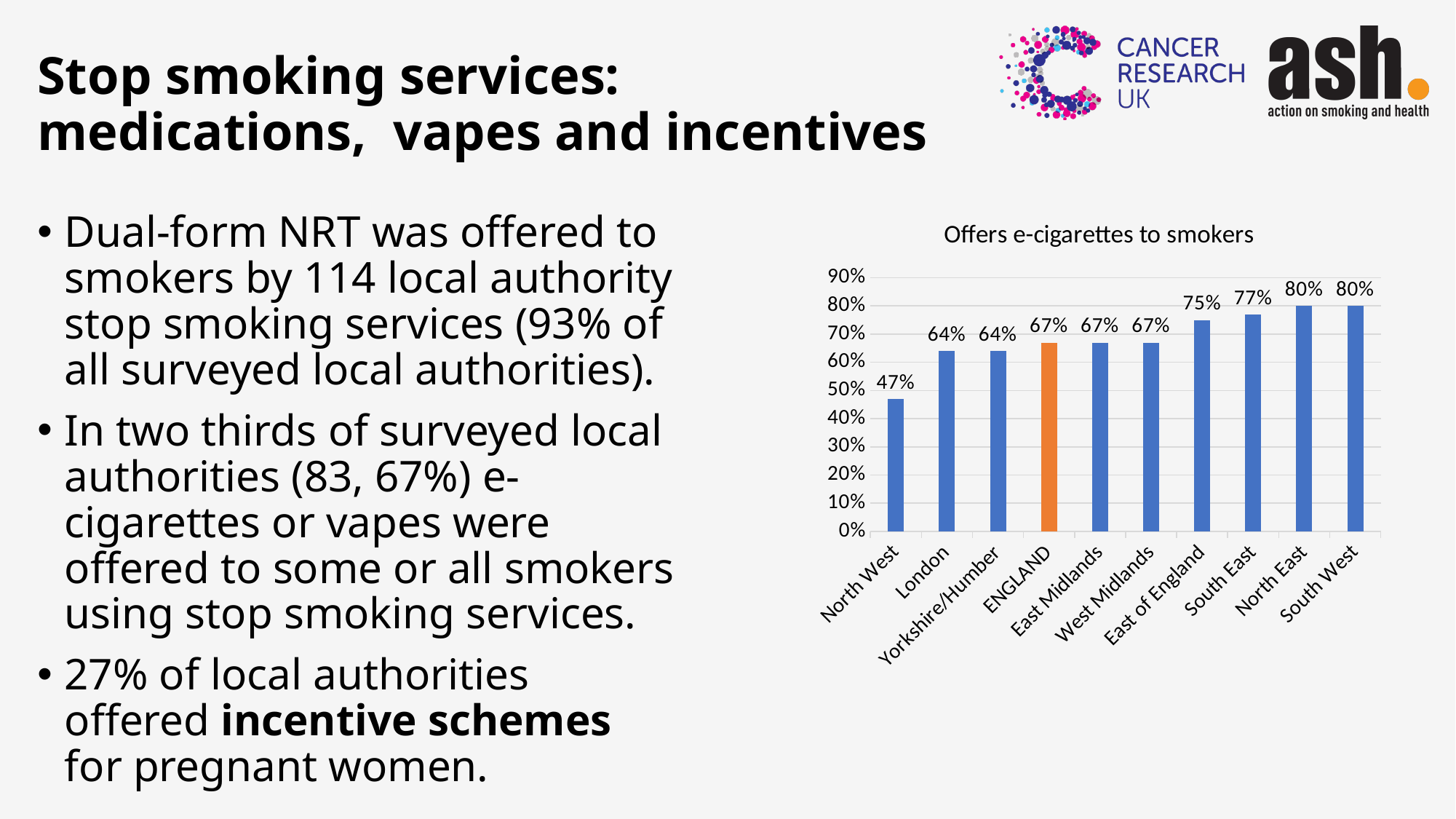
What is the title of the chart? Offers e-cigarettes to smokers What is the value for North West in the chart? 47% Is the value for North West greater or less than 50%? less What is the difference between the values for East of England and London? 11% Which is larger, the value for South East or the value for Yorkshire/Humber? South East What is the value for East of England in the chart? 75% What is the value for South East in the chart? 77% What kind of chart is shown on the slide? bar chart Which category has the lowest value in the chart? North West What is the difference between the values for South West and North West? 33% What is the value for ENGLAND in the chart? 67% How many categories are shown on the x axis of the chart? 10